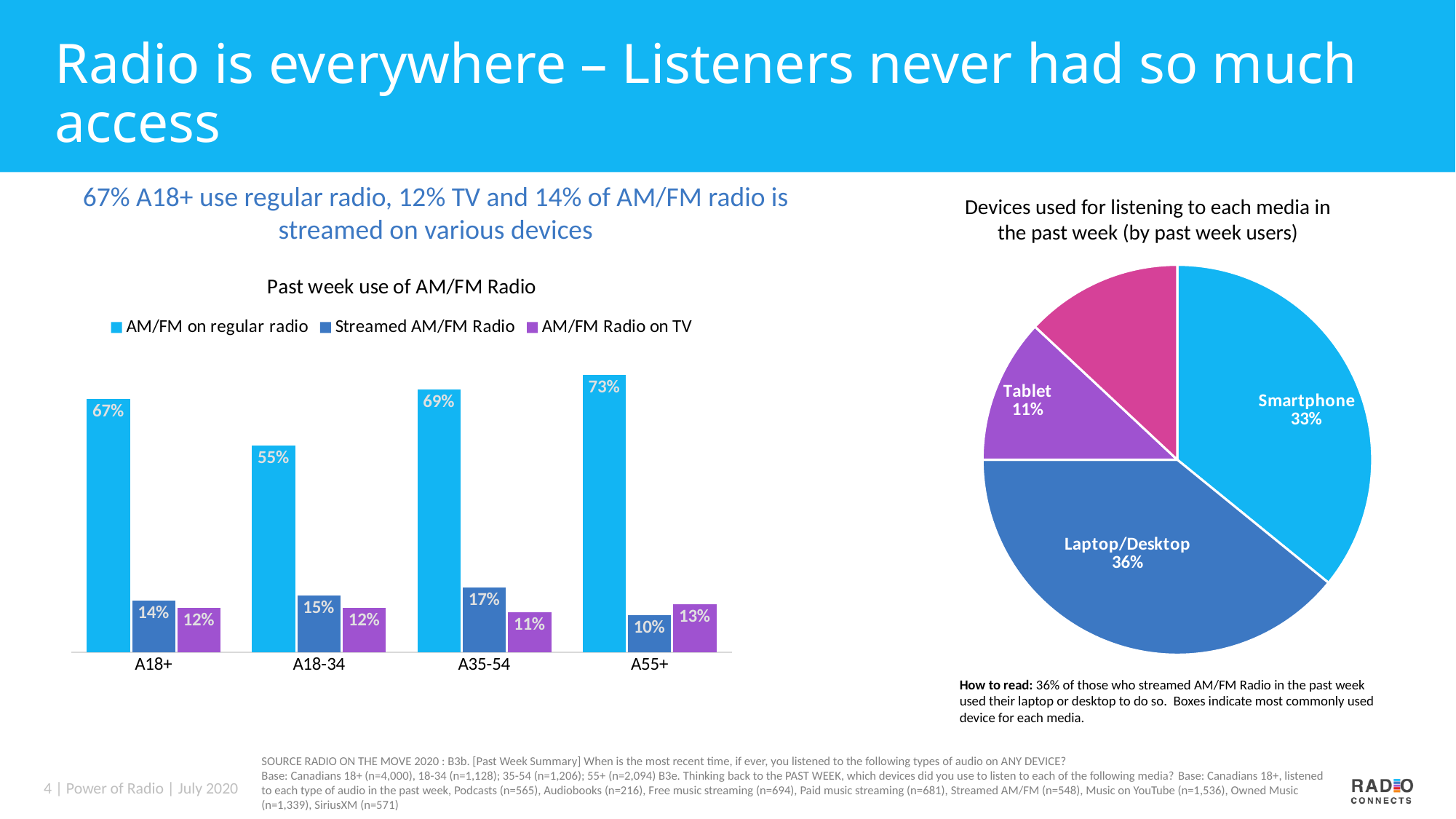
In the 'Past week use of AM/FM Radio' chart, which age group has the highest value for AM/FM on regular radio? A55+ What kind of chart is the 'Devices used for listening to each media in the past week' chart? Pie chart In the 'Past week use of AM/FM Radio' chart, what is the difference between AM/FM on regular radio for A55+ and for A18-34? 18% In the 'Devices used for listening to each media in the past week' pie chart, which is larger: Smartphone or Tablet? Smartphone In the 'Past week use of AM/FM Radio' chart, which is larger for A18+: Streamed AM/FM Radio or AM/FM Radio on TV? Streamed AM/FM Radio In the 'Past week use of AM/FM Radio' chart, what is the value for AM/FM Radio on TV for A18-34? 12% In the 'Past week use of AM/FM Radio' chart, what is the value for Streamed AM/FM Radio for A35-54? 17% In the 'Past week use of AM/FM Radio' chart, what is the value for AM/FM on regular radio for A55+? 73% How many series does the legend of the 'Past week use of AM/FM Radio' chart list? 3 In the 'Devices used for listening to each media in the past week' pie chart, what share is Laptop/Desktop? 36% How many age groups are shown on the x axis of the 'Past week use of AM/FM Radio' chart? 4 In the 'Past week use of AM/FM Radio' chart, which age group has the lowest value for Streamed AM/FM Radio? A55+